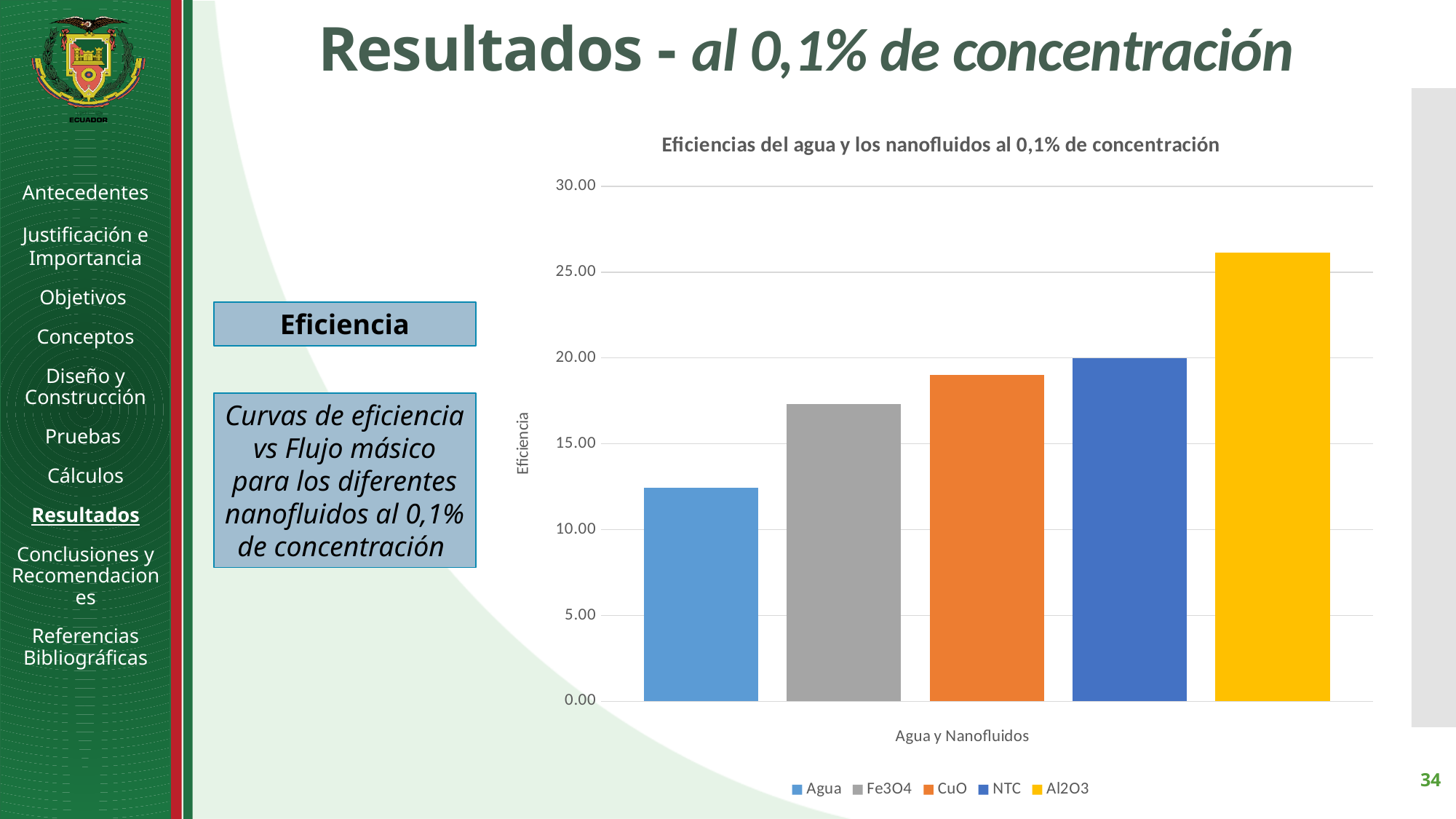
Which is larger, the value for CuO or the value for Agua? CuO Which category has the lowest efficiency in the chart? Agua Is the value for CuO greater or less than 20.00? less How many entries does the legend list? 5 Is the value for Agua greater or less than 15.00? less What type of chart is shown on the slide? bar chart Which category has the highest efficiency in the chart? Al2O3 How many bars are plotted in the chart? 5 Do the bar values rise or fall from left to right across the categories? rise What is the title of the chart? Eficiencias del agua y los nanofluidos al 0,1% de concentración Is the value for Fe3O4 greater or less than 15.00? greater